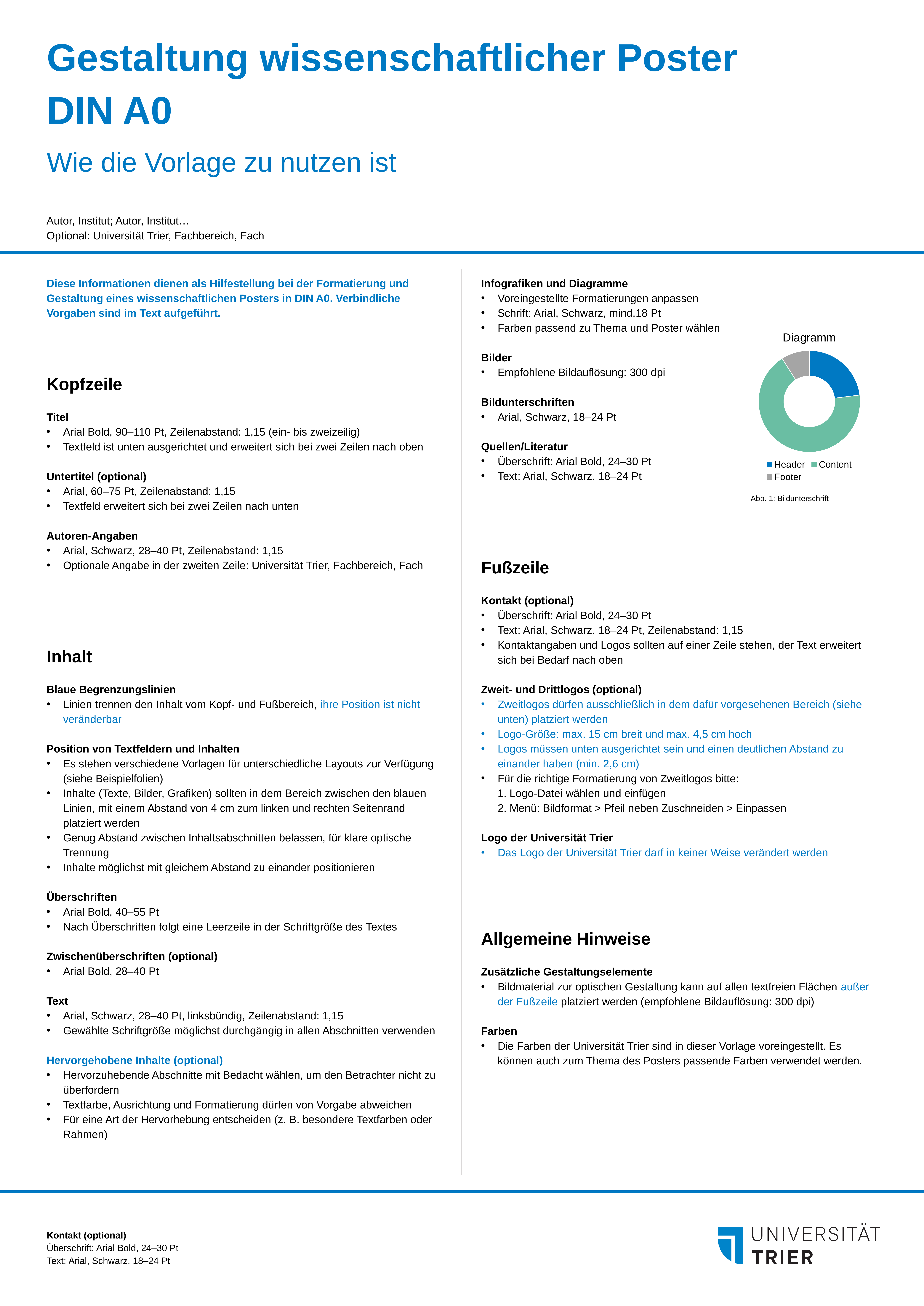
Which slice is larger, Header or Content? Content Which category has the smallest slice in the chart? Footer What colour represents the Header category in the chart? Blue How many entries does the chart legend list? 3 Which slice is larger, Content or Footer? Content Which category has the largest slice in the chart? Content How many slices does the doughnut chart have? 3 What kind of chart is shown on the slide? Doughnut chart Which slice is larger, Header or Footer? Header What is the title of the chart? Diagramm